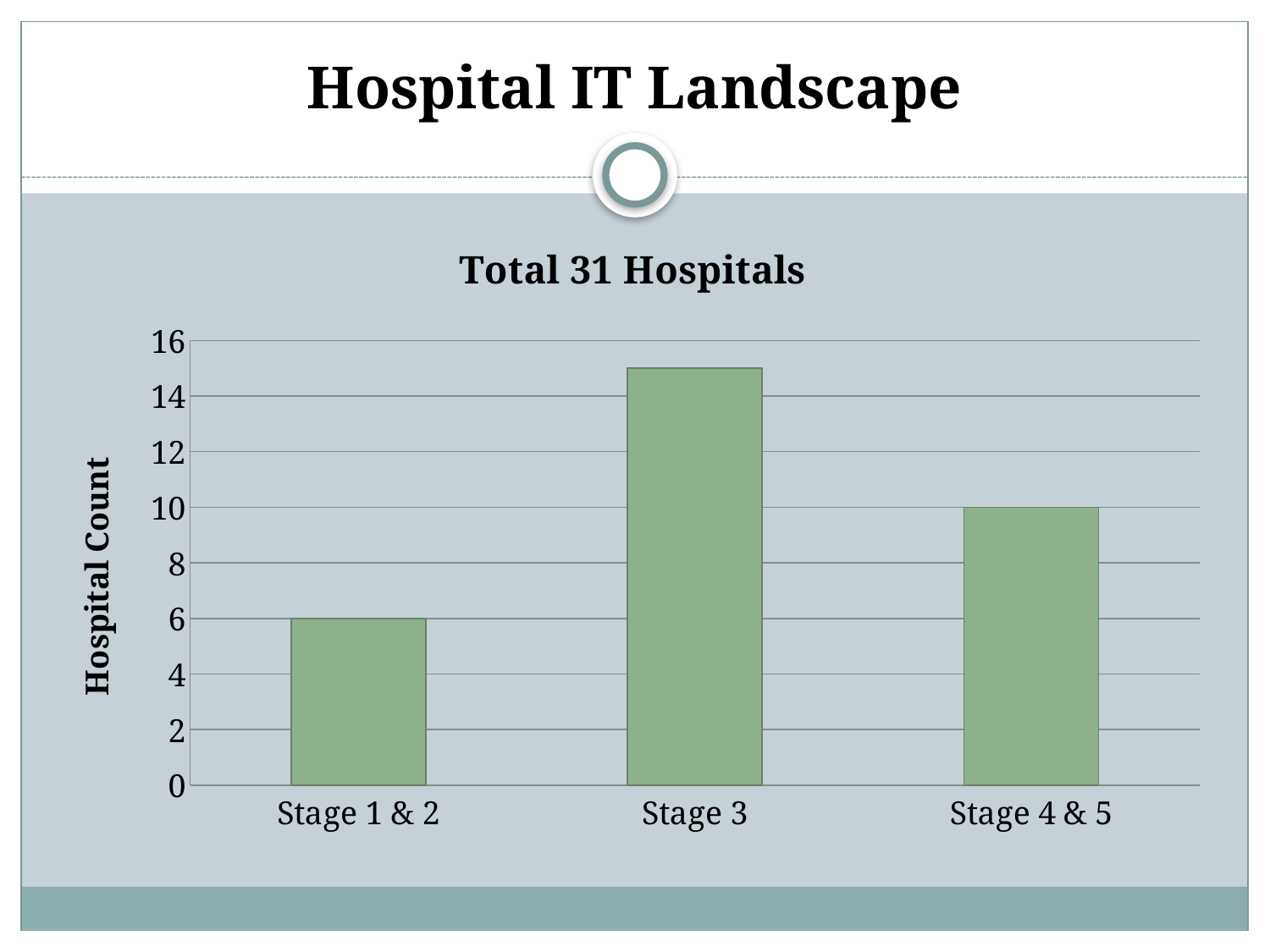
What is the difference between the values for Stage 4 & 5 and Stage 1 & 2? 4 Which category has the lowest hospital count? Stage 1 & 2 What is the title of the chart? Total 31 Hospitals Is the value for Stage 3 greater or less than 14? greater What is the label of the vertical axis? Hospital Count What is the value for Stage 4 & 5? 10 Which category has the highest hospital count? Stage 3 How many categories are shown on the x axis? 3 What is the value for Stage 1 & 2? 6 Is the value for Stage 1 & 2 greater or less than 8? less What kind of chart is shown on the slide? bar chart Which is larger, the value for Stage 3 or the value for Stage 4 & 5? Stage 3